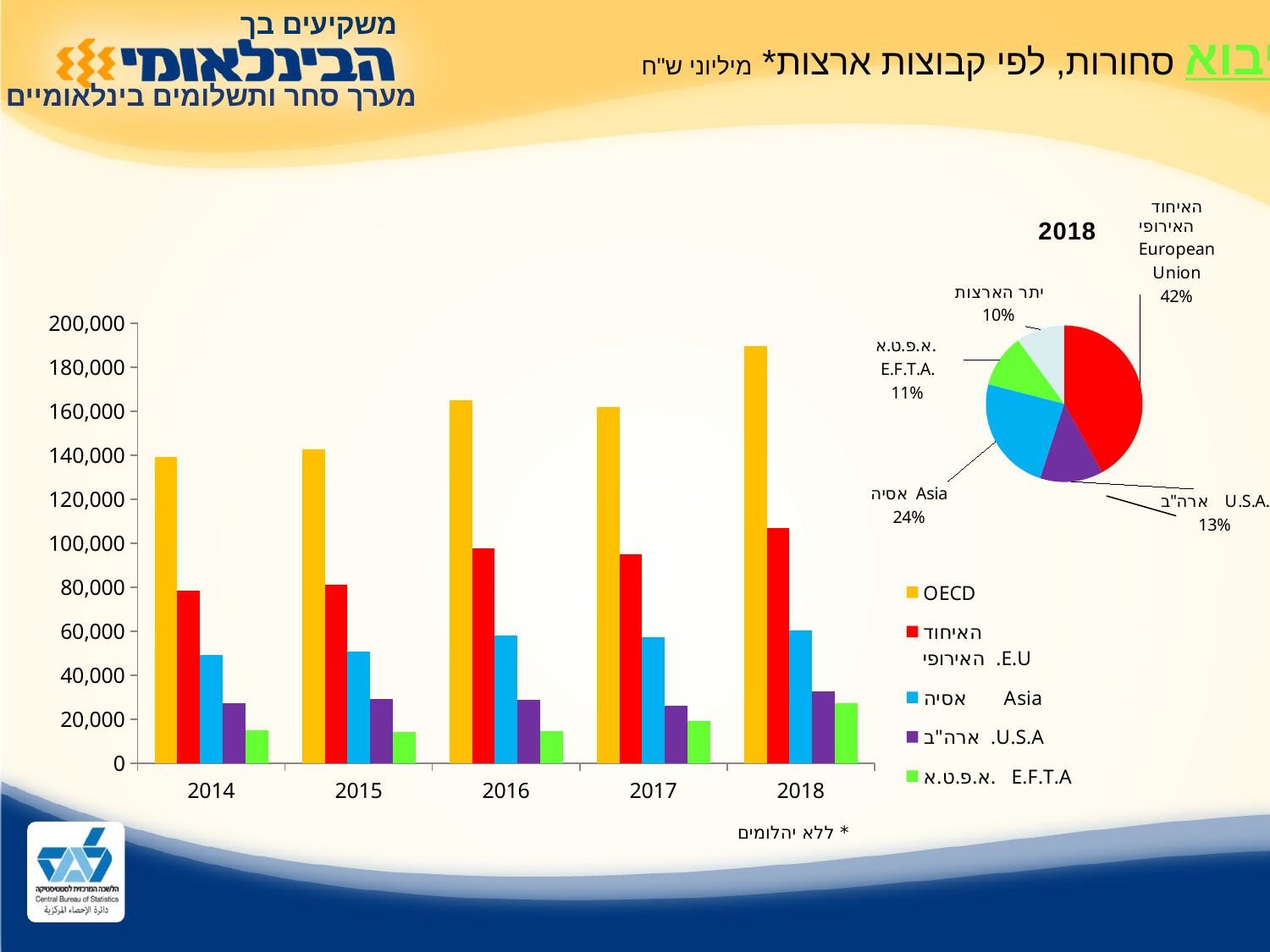
In the pie chart, what is the difference in percentage points between the Asia share and the U.S.A. share? 11 percentage points In the pie chart, which country group has the largest slice? European Union (האיחוד האירופי) How many series does the legend of the bar chart list? 5 What kind of chart is the large chart on the left of the slide? Bar chart In the bar chart, is the E.F.T.A value for 2014 greater or less than 20,000? less In the pie chart, which slice is the smallest? יתר הארצות (other countries), 10% How many slices does the pie chart have? 5 In the bar chart, which year has the highest OECD value? 2018 In the bar chart, which series has the lowest value in every year? E.F.T.A (א.פ.ט.א) How many years are shown on the x axis of the bar chart? 5 In the pie chart, what share of imports in 2018 came from the European Union? 42% In the bar chart, is the OECD value for 2018 greater or less than 180,000? greater